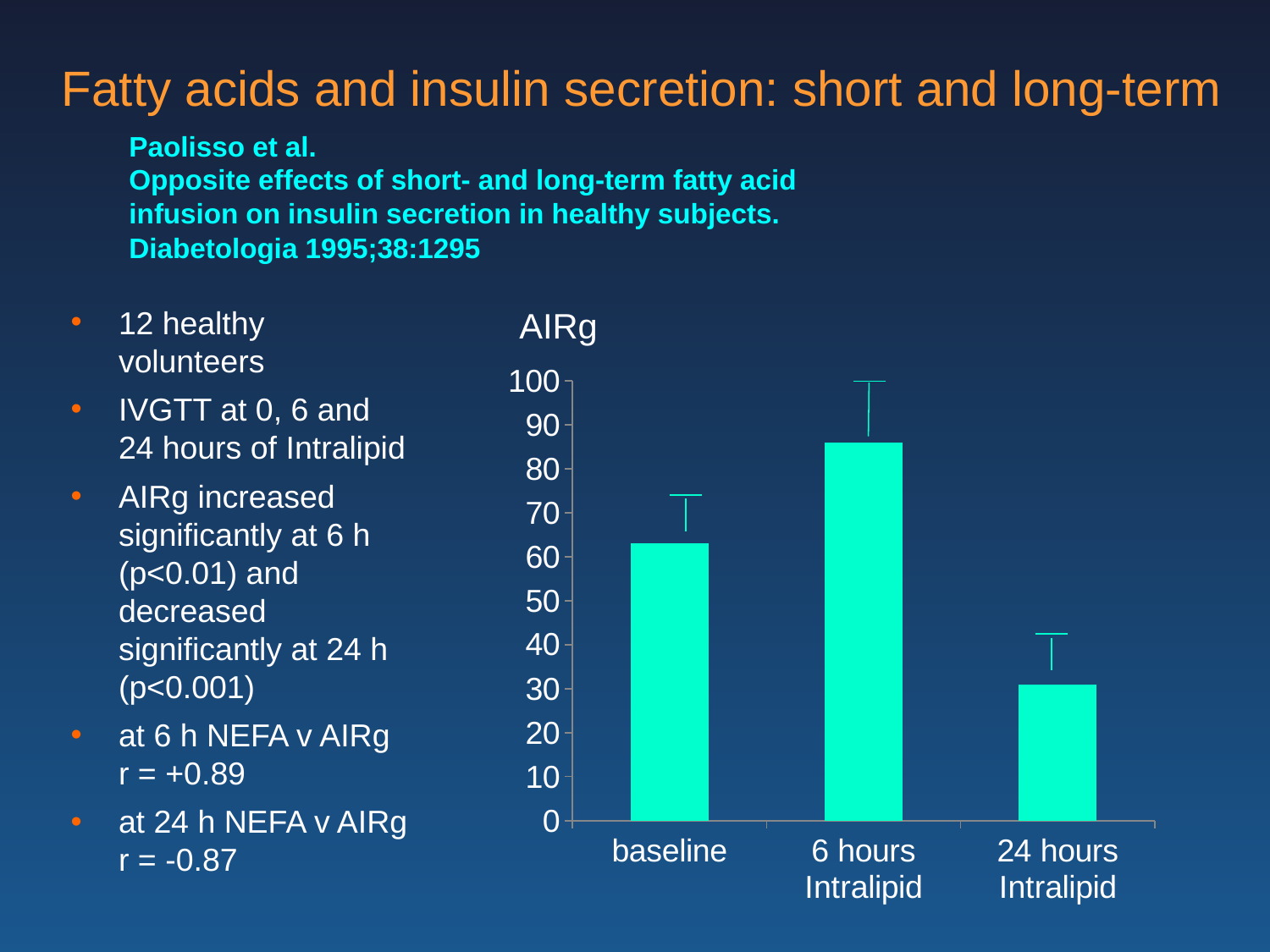
What kind of chart is shown on the slide? bar chart Which is larger, the AIRg value at baseline or at 6 hours Intralipid? 6 hours Intralipid Is the AIRg value for 6 hours Intralipid greater or less than 80? greater What is the title of the chart? AIRg What is the highest value shown on the chart's vertical axis? 100 Which category has the lowest AIRg value? 24 hours Intralipid Which is larger, the AIRg value at baseline or at 24 hours Intralipid? baseline Is the AIRg value for 24 hours Intralipid greater or less than 40? less Does the AIRg value rise or fall from 6 hours Intralipid to 24 hours Intralipid? fall Is the AIRg value for baseline greater or less than 50? greater Which category has the highest AIRg value? 6 hours Intralipid How many bars (categories) does the AIRg chart show? 3